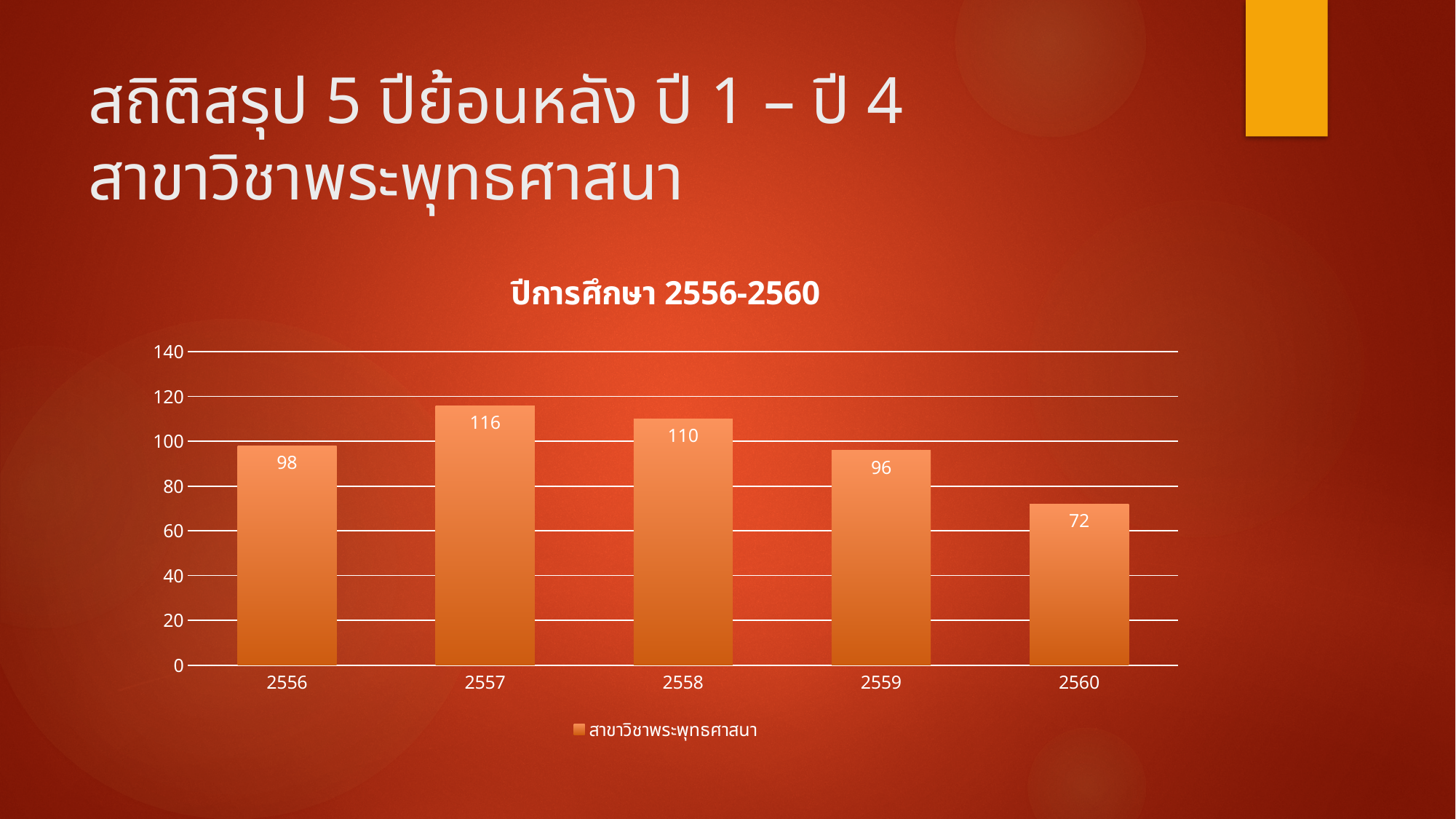
What is the difference between the values for 2557 and 2560? 44 What is the value for 2560? 72 What is the value for 2557? 116 Which is larger, the value for 2556 or the value for 2559? 2556 How many series does the legend list? 1 What is the title of the chart? ปีการศึกษา 2556-2560 Is the value for 2559 greater or less than 100? less Which year has the lowest value? 2560 What is the value for 2558? 110 What kind of chart is shown? bar chart How many years are shown on the x axis? 5 Which year has the highest value? 2557